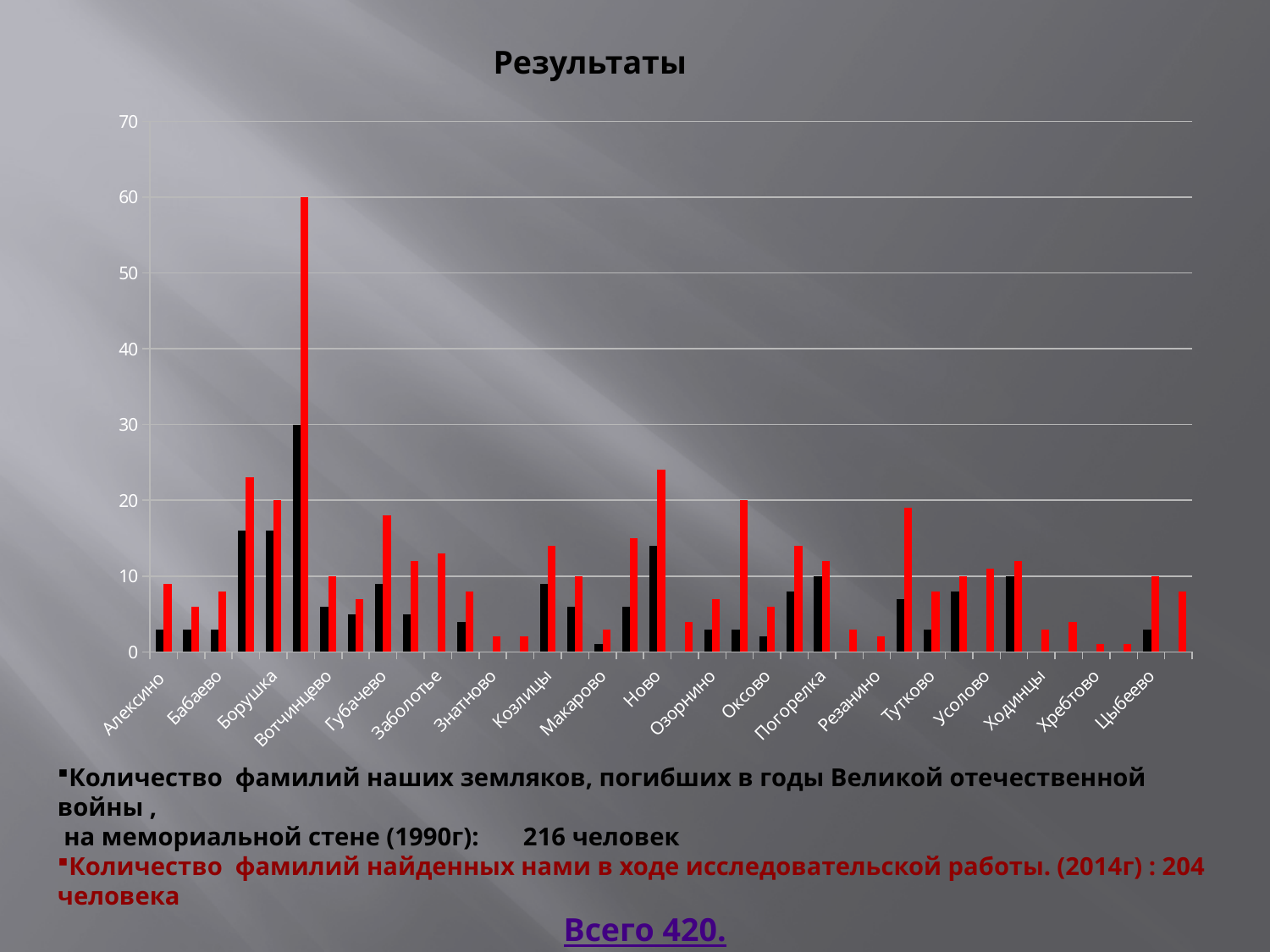
What is the highest value reached by any bar in the chart? 60 Is the value of the black bar for Ново greater or less than 10? greater Is the value of the red bar for Ново greater or less than 20? greater Is the tallest bar in the chart black or red? red What type of chart is shown on the slide? bar chart What two colours are used for the bars in the chart? black and red Is the value of the red bar for Хребтово greater or less than 10? less Which has the taller black bar, Борушка or Алексино? Борушка Which has the taller red bar, Ново or Оксово? Ново What is the title of the chart? Результаты